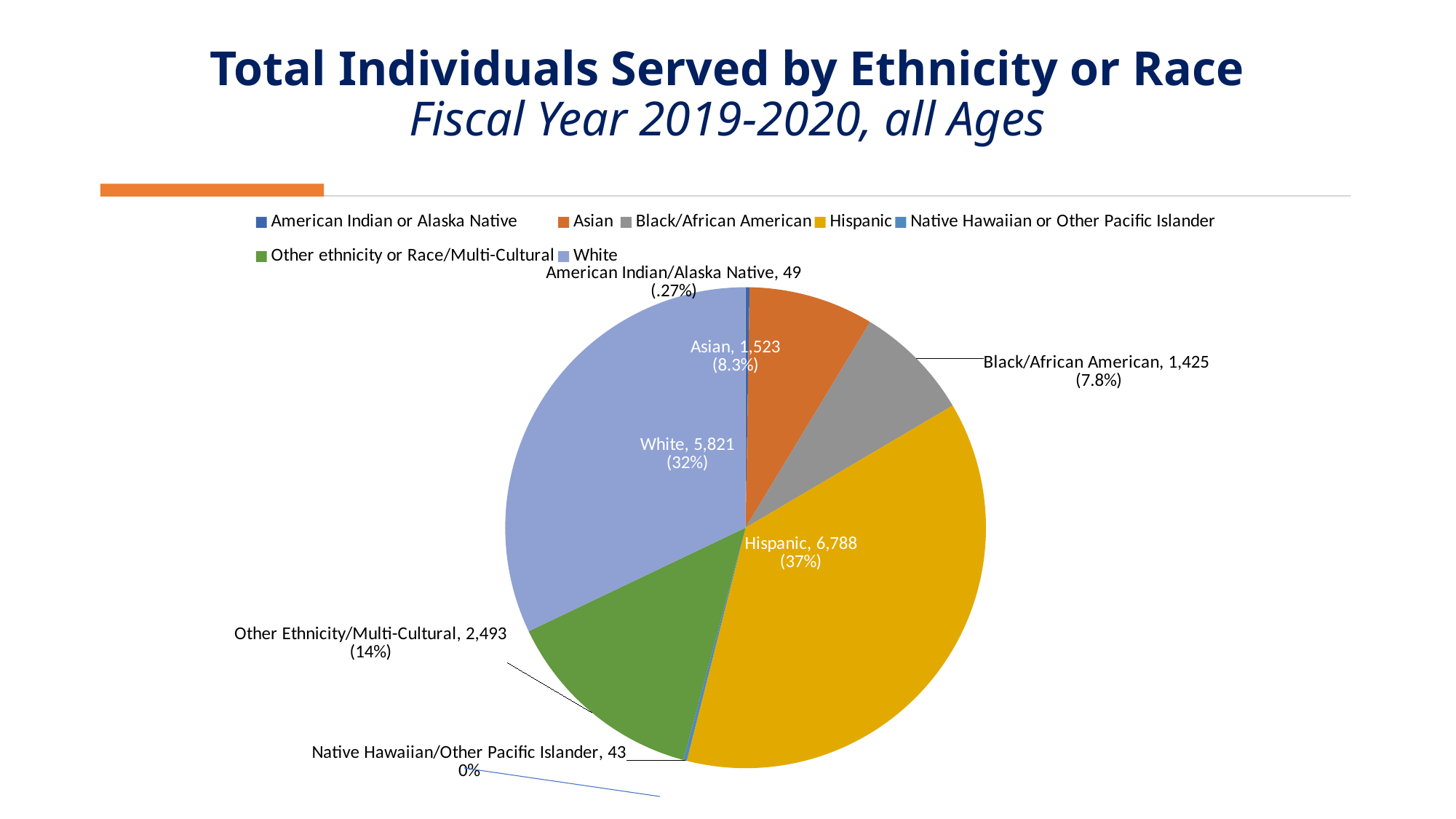
Which group has more individuals served, Other Ethnicity/Multi-Cultural or Asian? Other Ethnicity/Multi-Cultural Which ethnicity or race group has the largest number of individuals served? Hispanic How many individuals served were White? 5,821 What is the difference between the number of Asian and Black/African American individuals served? 98 What is the difference between the number of Hispanic and White individuals served? 967 How many individuals served were Black/African American? 1,425 Which ethnicity or race group has the smallest number of individuals served? Native Hawaiian/Other Pacific Islander What share of the pie does the White slice represent? 32% How many entries does the legend list? 7 How many individuals served were Native Hawaiian/Other Pacific Islander? 43 What type of chart is shown on the slide? pie chart How many individuals served were Hispanic? 6,788